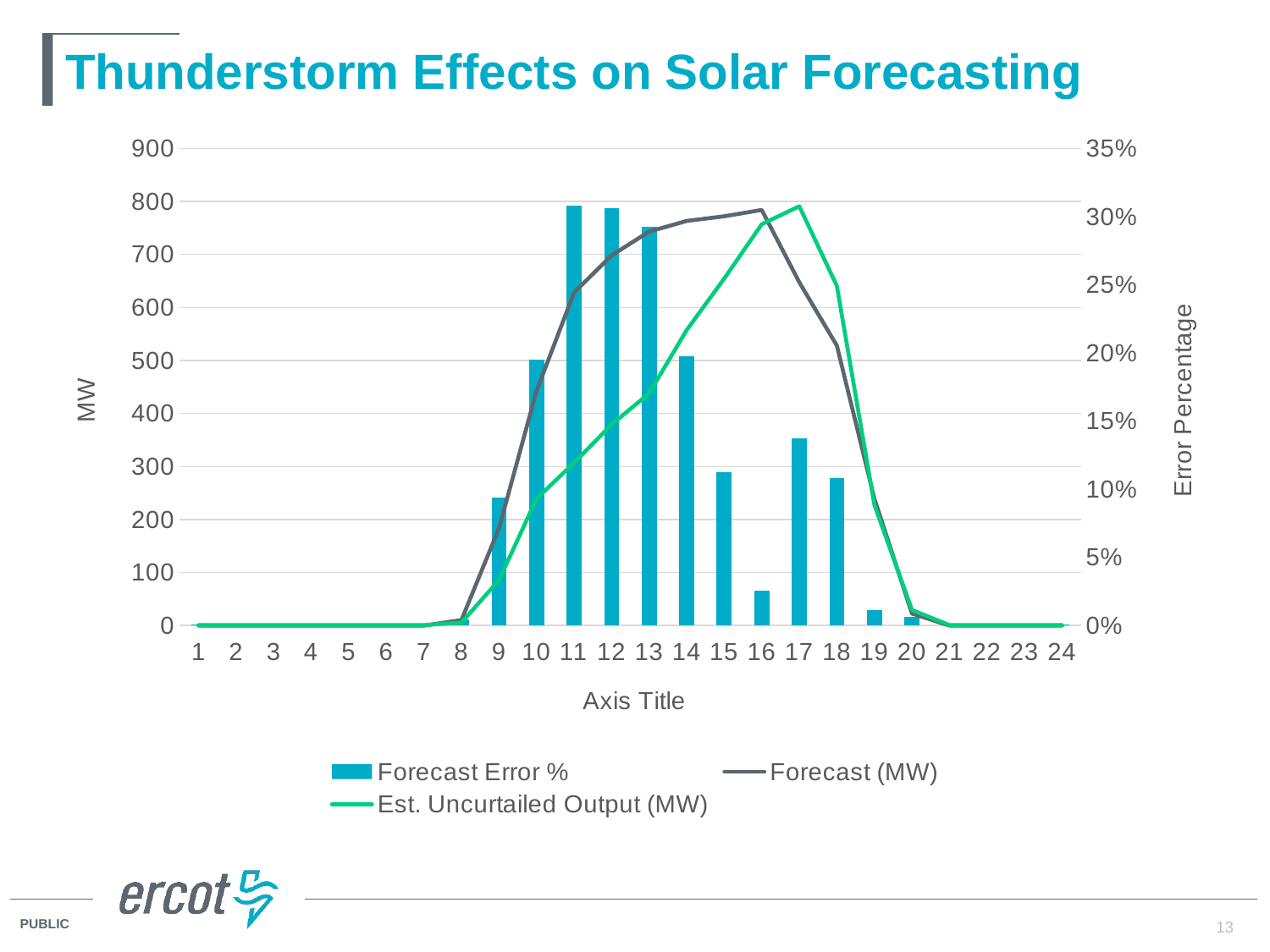
Is the Forecast (MW) value at hour 16 greater or less than 700? greater Does the Forecast (MW) line rise or fall from hour 8 to hour 16? rise At hour 17, which is larger: Forecast (MW) or Est. Uncurtailed Output (MW)? Est. Uncurtailed Output (MW) What is the title of the chart on this slide? Thunderstorm Effects on Solar Forecasting What is the label of the right-hand vertical axis? Error Percentage Is the Forecast Error % value at hour 11 greater or less than 25%? greater At hour 12, which is larger: Forecast (MW) or Est. Uncurtailed Output (MW)? Forecast (MW) Is the Est. Uncurtailed Output (MW) value at hour 11 greater or less than 400? less What kind of chart is shown on the slide? Combined bar and line chart How many categories are shown along the x axis of the chart? 24 How many series does the chart legend list? 3